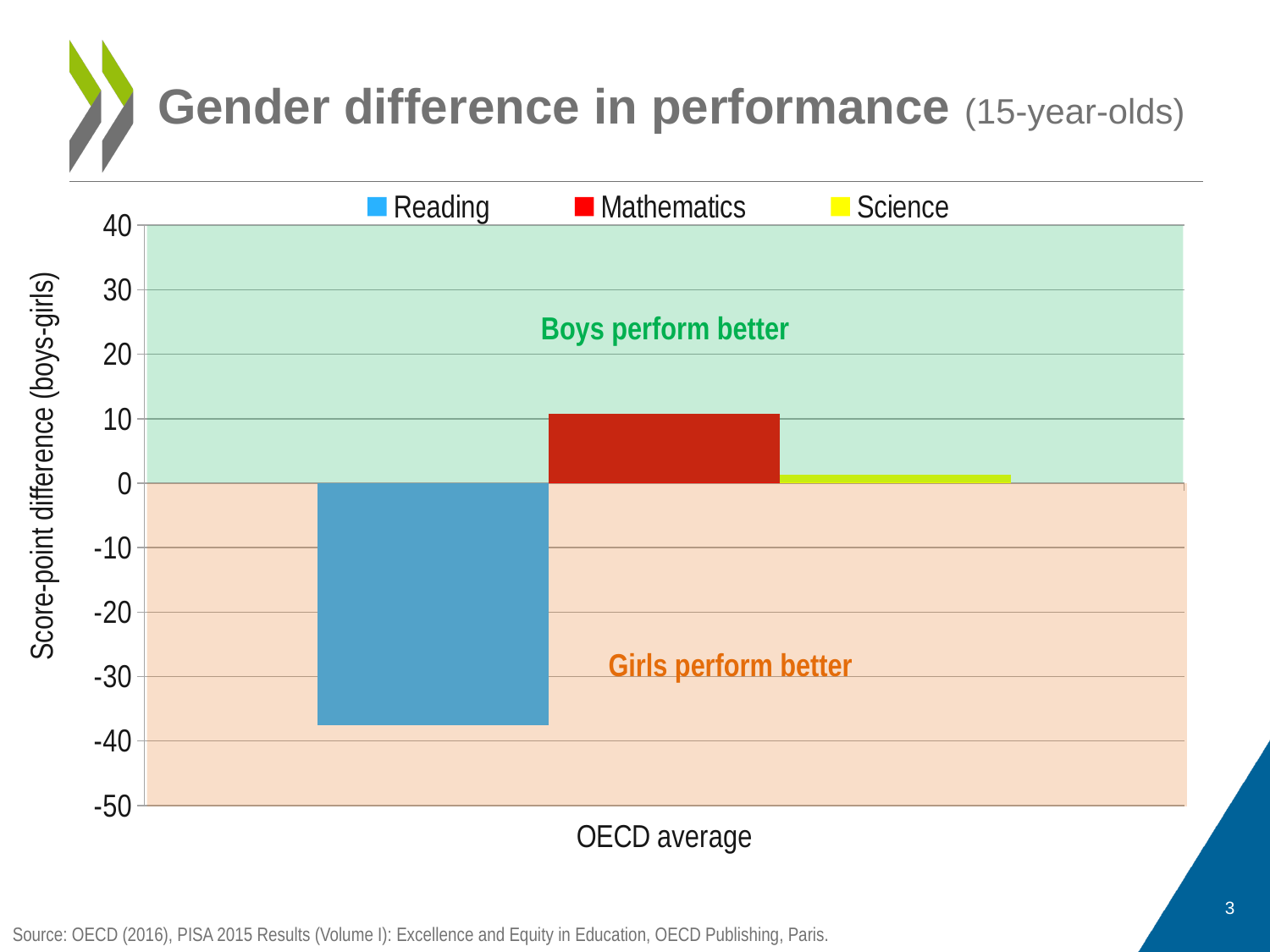
Is the value for Reading greater or less than -20? less Is the value for Science greater or less than 10? less How many categories are shown on the x axis? 1 Which series has the lowest value for the OECD average? Reading What is the label of the y axis? Score-point difference (boys-girls) Is the value for Mathematics greater or less than 0? greater Which is larger, the value for Mathematics or the value for Science? Mathematics How many series does the legend list? 3 What is the label of the category on the x axis? OECD average What kind of chart is shown on the slide? bar chart Which series has the highest value for the OECD average? Mathematics Which is larger, the value for Reading or the value for Science? Science